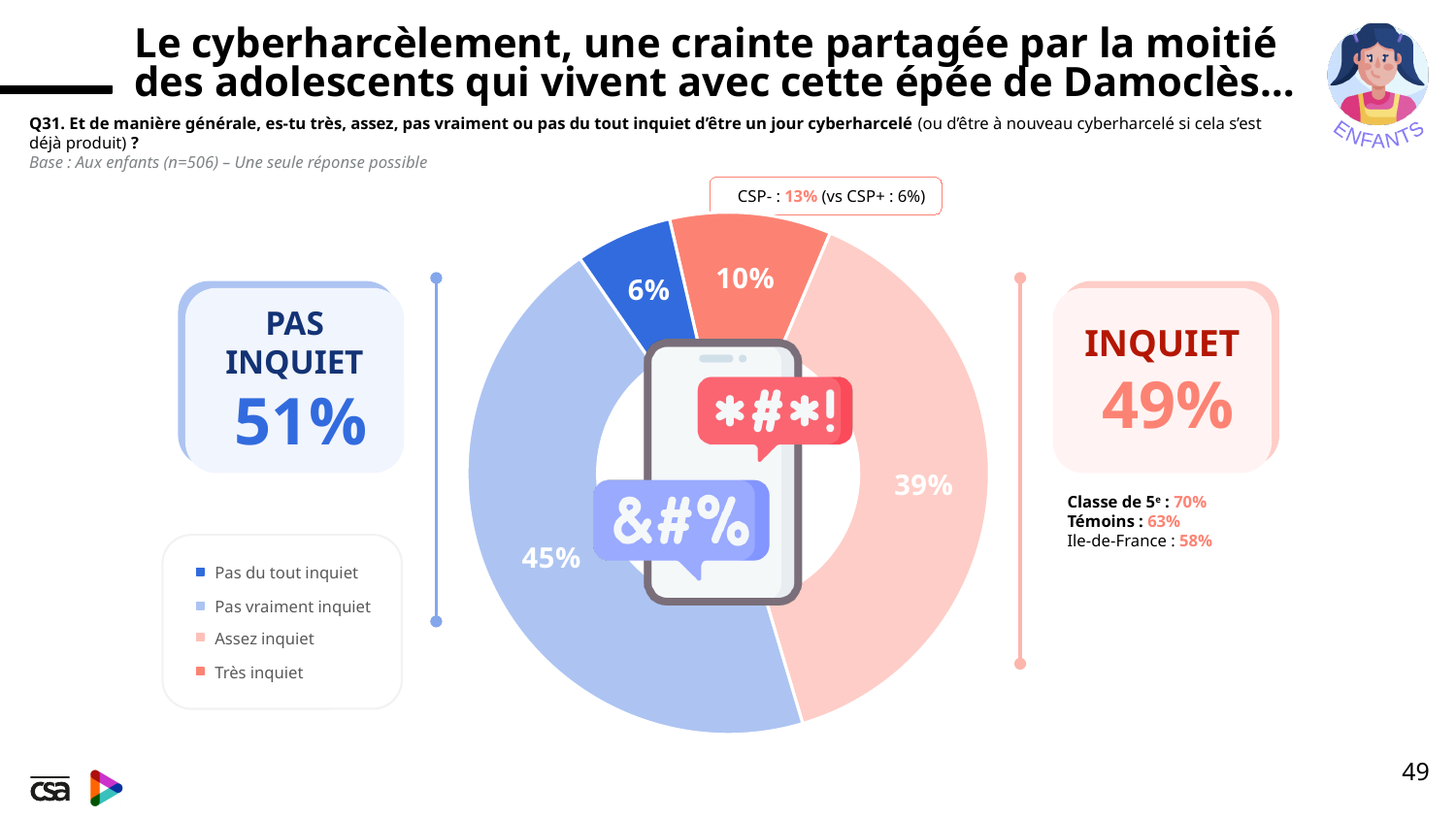
How many response categories does the legend list? 4 What is the difference in percentage points between "Pas vraiment inquiet" and "Assez inquiet"? 6 What is the combined share of "Assez inquiet" and "Très inquiet" (the "INQUIET" total shown on the slide)? 49% What kind of chart is shown on the slide? Pie chart (donut) Which is larger: the share for "Très inquiet" or the share for "Pas du tout inquiet"? Très inquiet Which response category has the largest share of the pie? Pas vraiment inquiet What percentage of children answered "Assez inquiet"? 39% What percentage of children answered "Pas vraiment inquiet"? 45% What percentage of children answered "Pas du tout inquiet"? 6% What is the combined share of "Pas du tout inquiet" and "Pas vraiment inquiet" (the "PAS INQUIET" total shown on the slide)? 51% What percentage of children answered "Très inquiet"? 10% Which response category has the smallest share of the pie? Pas du tout inquiet